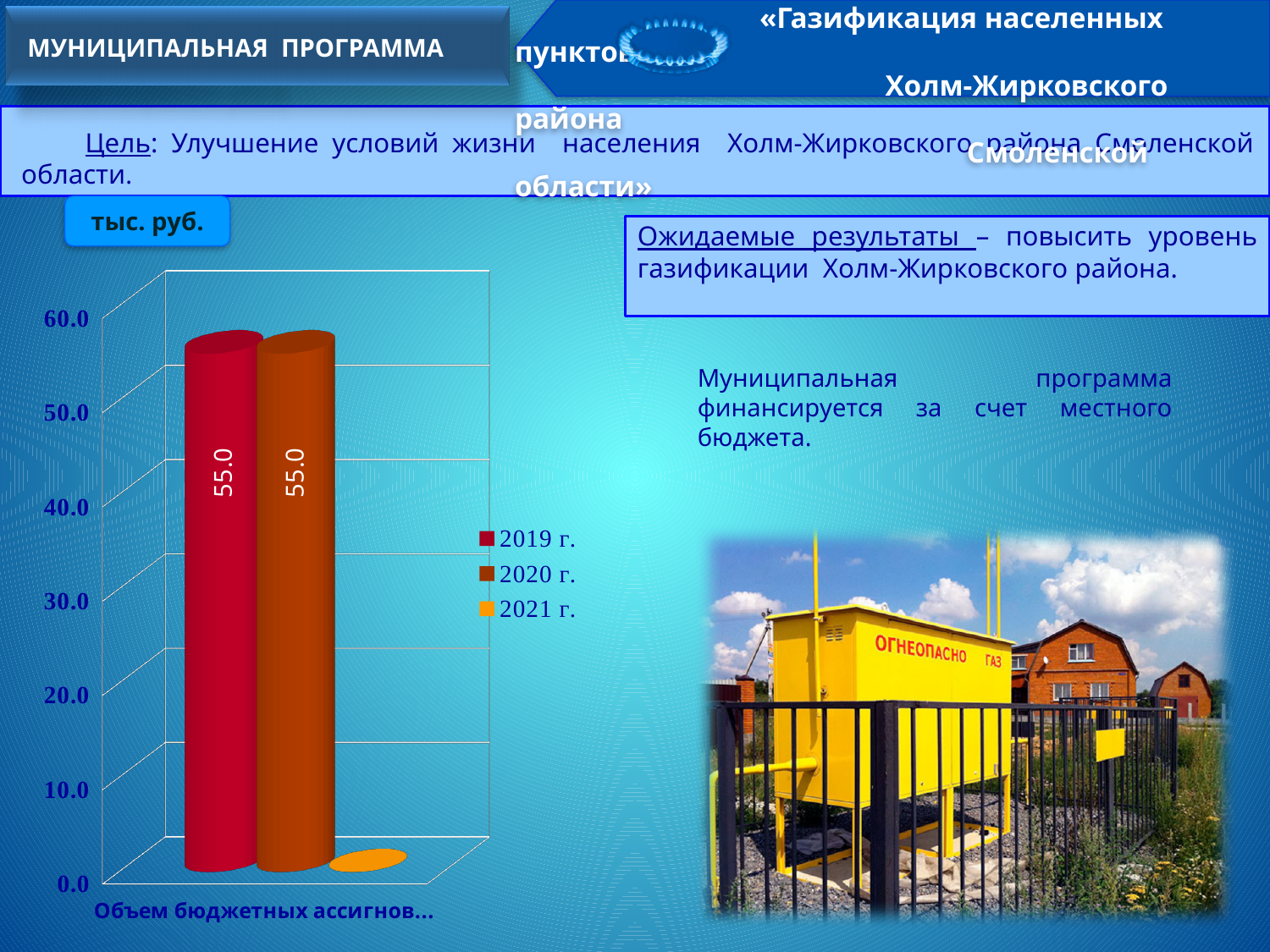
How many categories are shown on the horizontal axis of the chart? 1 What is the highest tick value shown on the vertical axis of the chart? 60.0 What kind of chart is shown on the slide? bar chart How many series does the chart legend list? 3 What is the difference between the 2019 г. and 2020 г. values? 0.0 Is the value for 2019 г. greater or less than 50.0? greater What is the value for the 2019 г. series on the chart? 55.0 What unit is indicated for the chart values in the label above the chart? тыс. руб. Is the value for 2021 г. greater or less than 10.0? less Which series has the lowest value on the chart? 2021 г. What is the value for the 2020 г. series on the chart? 55.0